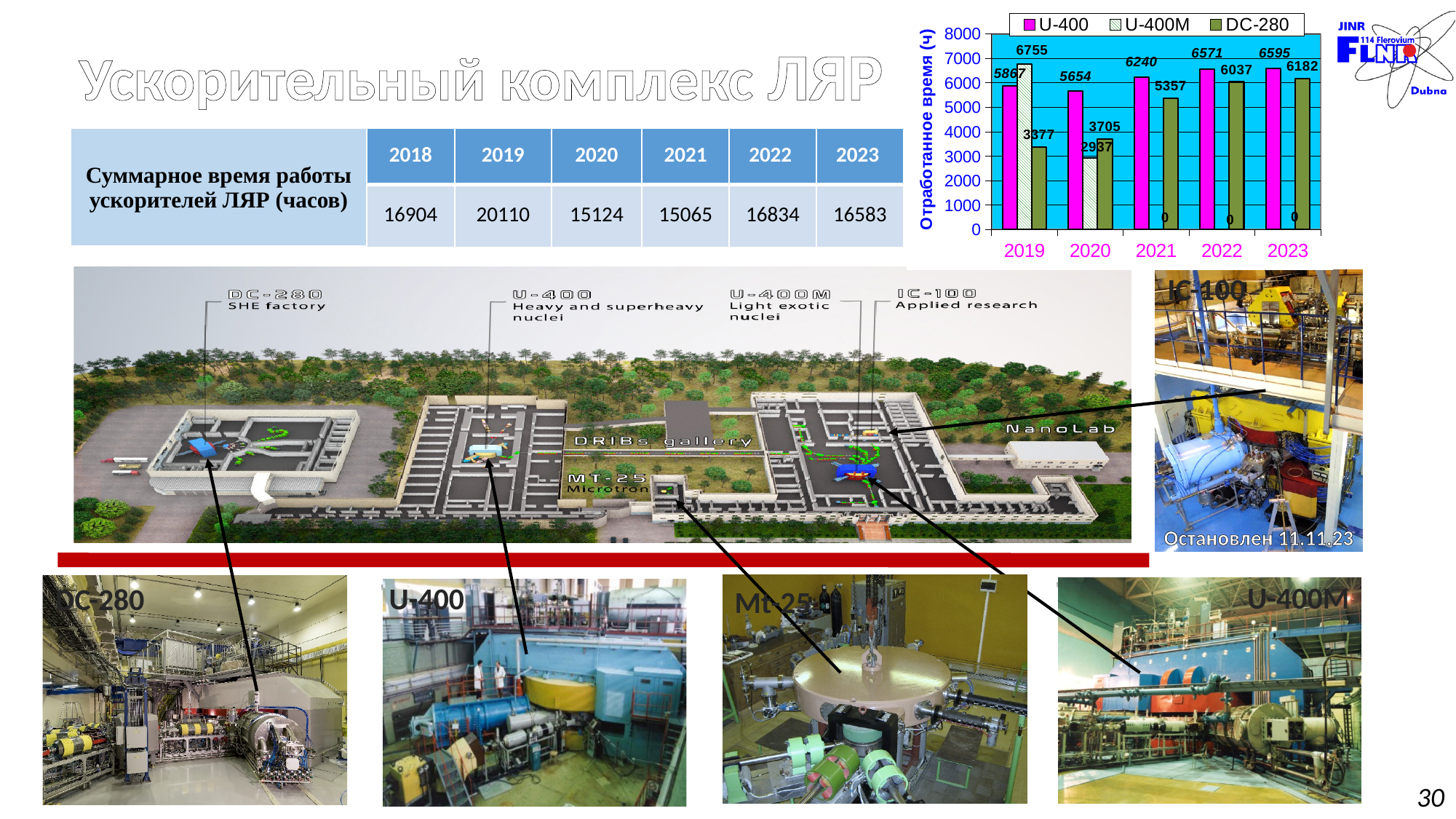
What is the value for DC-280 in 2020 in the bar chart? 3705 How many years are shown on the x axis of the bar chart? 5 What is the value for U-400M in 2021 in the bar chart? 0 What is the value for U-400M in 2019 in the bar chart? 6755 Which is larger in 2019 in the bar chart, U-400 or U-400M? U-400M What is the difference between the U-400 and DC-280 values in 2021 in the bar chart? 883 What is the value for U-400 in 2023 in the bar chart? 6595 Does the DC-280 value rise or fall from 2020 to 2023 in the bar chart? rise How many series does the legend of the bar chart list? 3 In which year is the DC-280 value lowest in the bar chart? 2019 In which year is the DC-280 value highest in the bar chart? 2023 What kind of chart is shown in the top right of the slide? bar chart